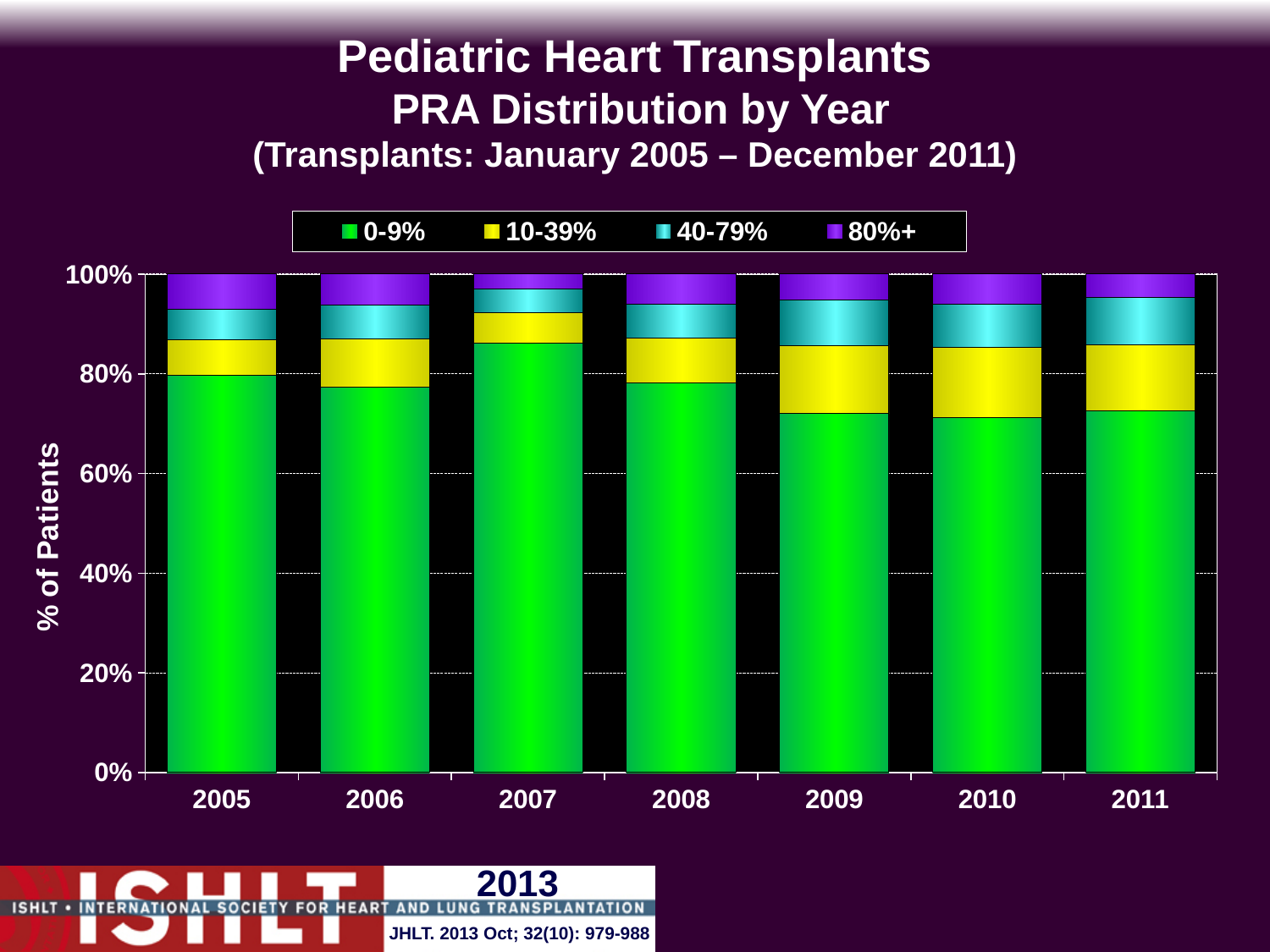
Does the share of patients in the 0-9% PRA category rise or fall from 2007 to 2010? fall How many years are shown along the x axis of the chart? 7 Which PRA category is shown in purple in the legend? 80%+ Is the share of patients in the 0-9% PRA category in 2009 greater or less than 80%? less Which year has the larger share of patients in the 0-9% PRA category, 2007 or 2010? 2007 How many PRA categories does the legend list? 4 What does each stacked bar total? 100% What kind of chart is shown on the slide? Stacked bar chart Is the share of patients in the 0-9% PRA category in 2010 greater or less than 80%? less What is the label on the y axis of the chart? % of Patients Which year has the largest share of patients in the 0-9% PRA category? 2007 Is the share of patients in the 0-9% PRA category in 2007 greater or less than 80%? greater